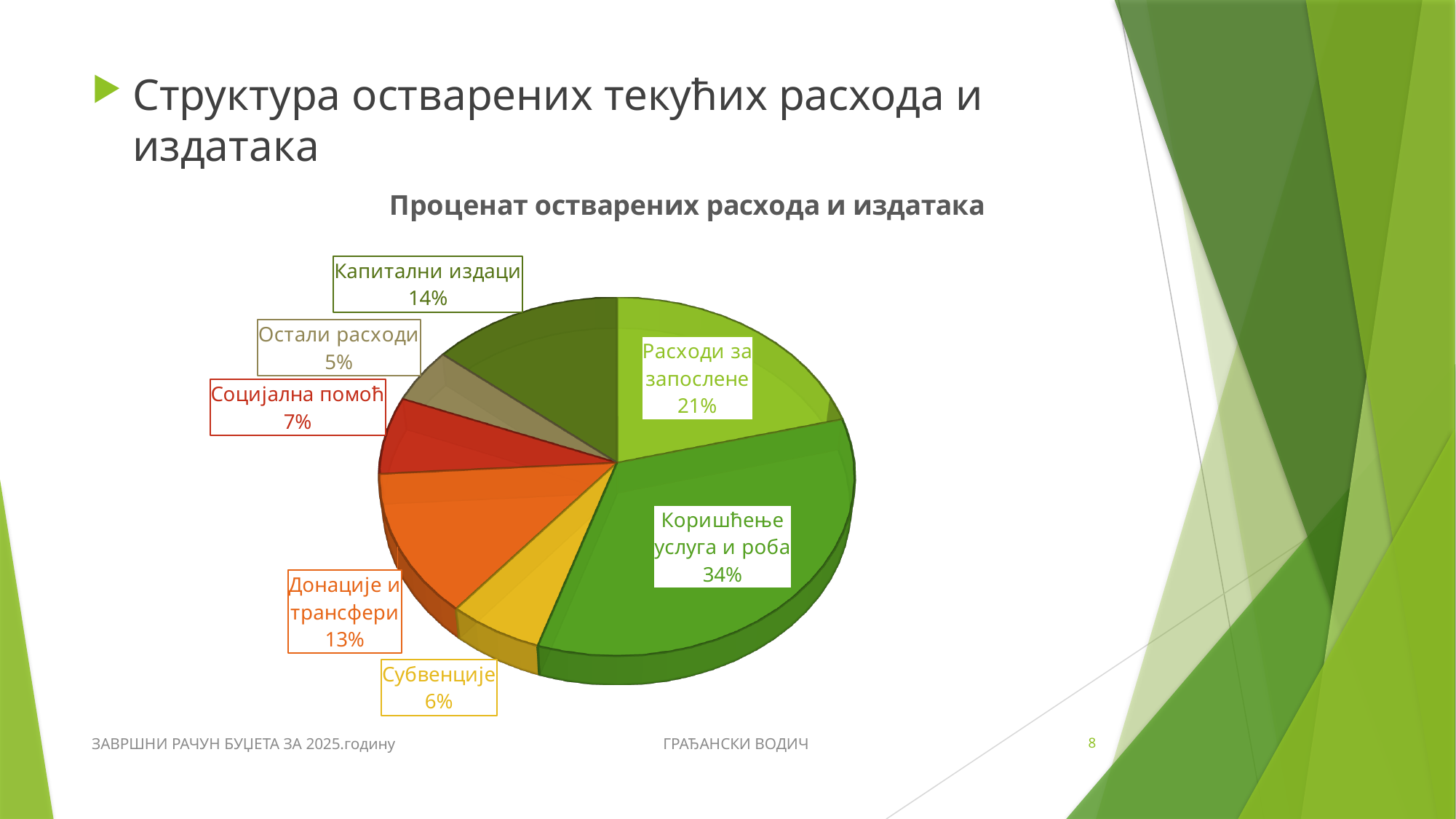
Which category has the smallest share of the pie? Остали расходи Which is larger, Социјална помоћ or Субвенције? Социјална помоћ What kind of chart is shown on the slide? pie chart What is the title of the chart? Проценат остварених расхода и издатака What is the difference in percentage points between Коришћење услуга и роба and Расходи за запослене? 13 What share of the pie is Коришћење услуга и роба? 34% Which category has the largest share of the pie? Коришћење услуга и роба What is the value shown for Капитални издаци? 14% How many slices does the pie chart have? 7 What is the value shown for Донације и трансфери? 13% What is the value shown for Расходи за запослене? 21% What is the combined share of Капитални издаци and Остали расходи? 19%